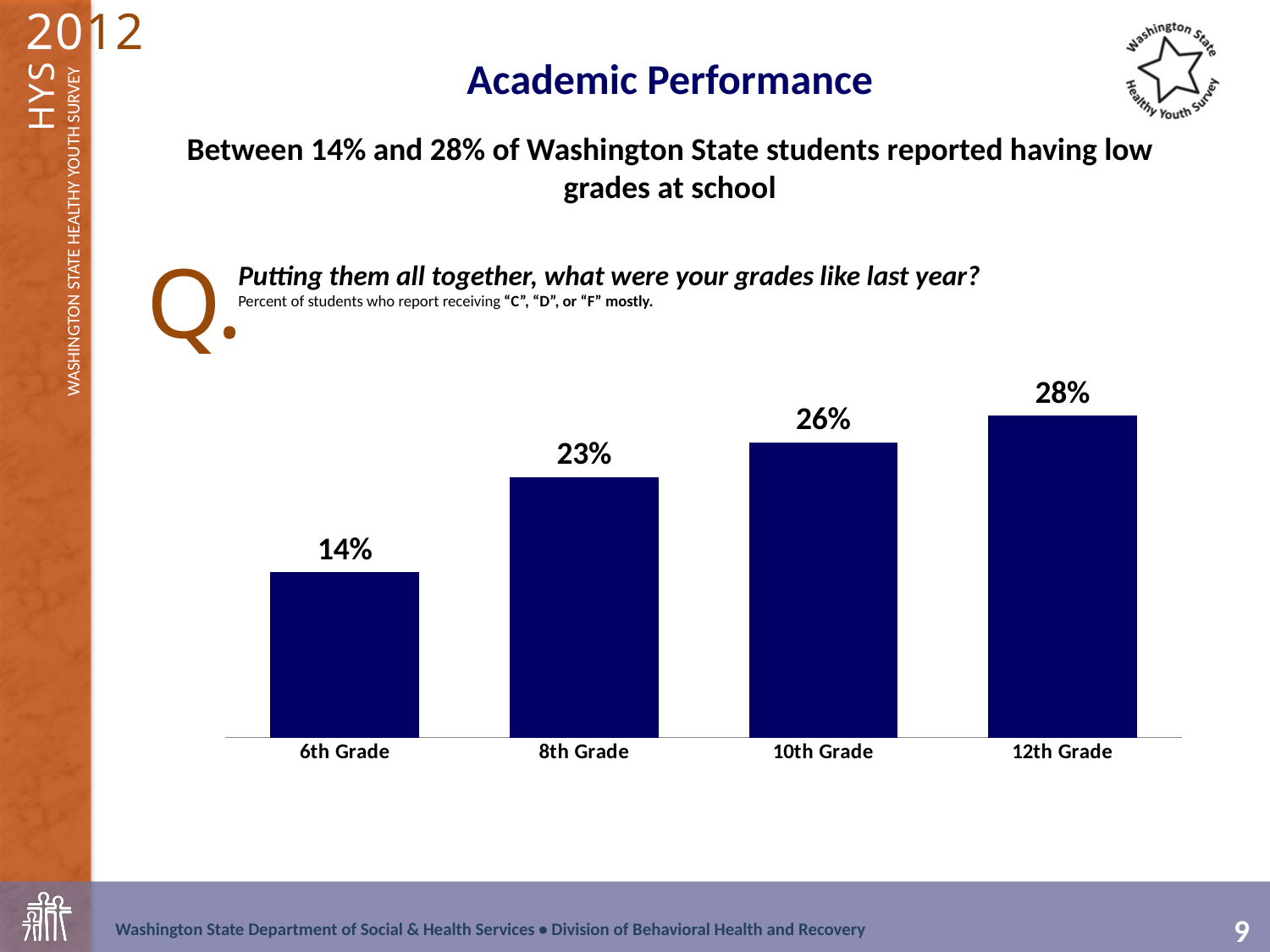
What kind of chart is shown on the slide? Bar chart What is the difference between the 12th Grade and 6th Grade values? 14% Which grade level has the lowest percentage of students reporting low grades? 6th Grade Which is larger, the value for 8th Grade or the value for 10th Grade? 10th Grade Do the values rise or fall from 6th Grade to 12th Grade? Rise What is the value shown for 10th Grade? 26% How many grade levels are shown in the chart? 4 What percent of 6th Grade students reported receiving mostly C, D, or F grades? 14% What is the value shown for 8th Grade? 23% What is the difference between the 10th Grade and 8th Grade values? 3% What is the value shown for 12th Grade? 28% Which grade level has the highest percentage of students reporting low grades? 12th Grade